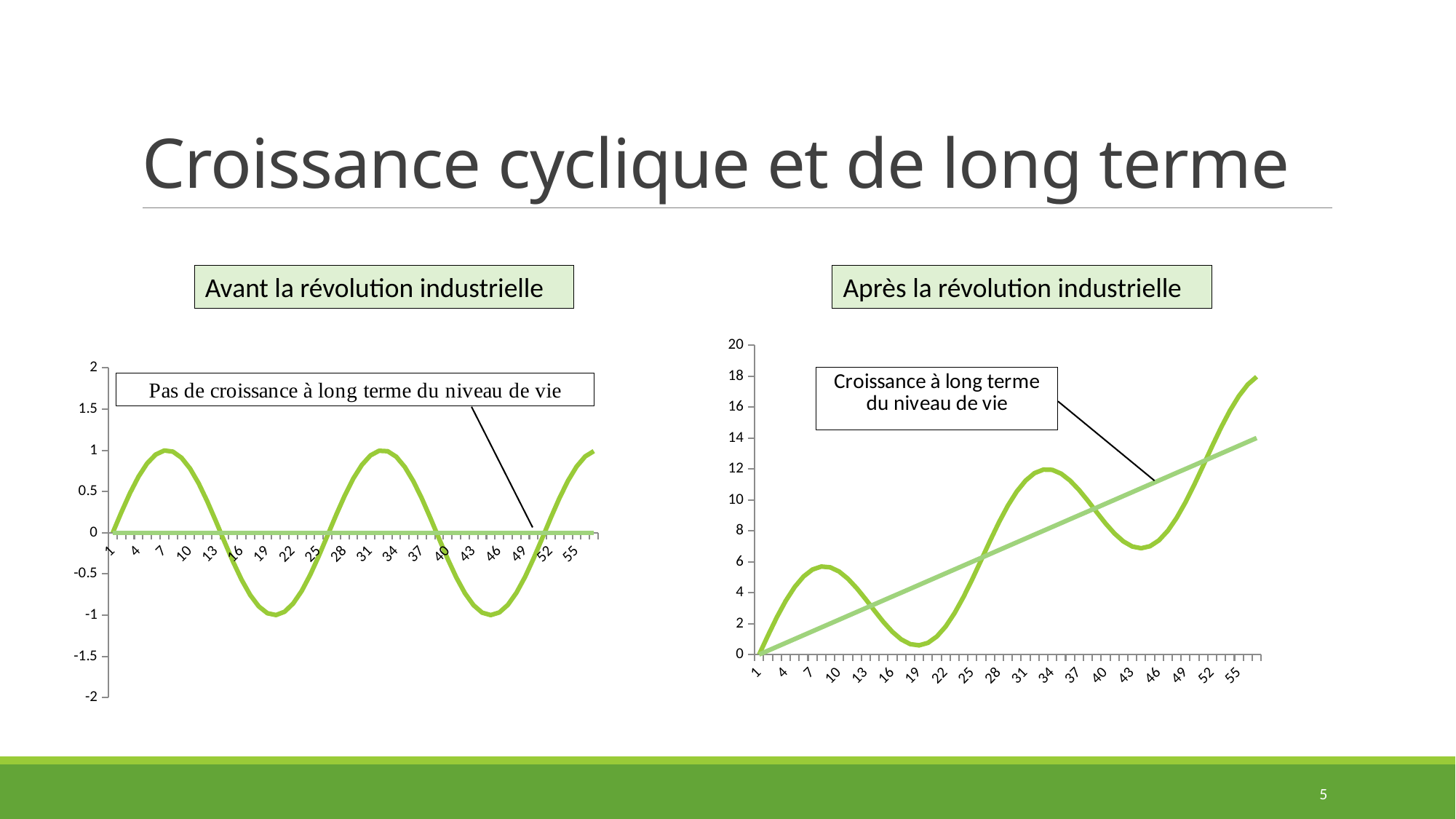
In the "Après la révolution industrielle" chart, is the value of the wavy line at x = 19 greater or less than 2? less In the "Après la révolution industrielle" chart, does the straight line rise or fall along the x axis? Rise In the "Avant la révolution industrielle" chart, what is the lowest value reached by the wavy line? -1 In the "Après la révolution industrielle" chart, is the value of the wavy line at x = 34 greater or less than 10? greater In the "Après la révolution industrielle" chart, what is the highest value shown on the y axis? 20 What kind of chart is shown under "Après la révolution industrielle"? Line chart In the "Après la révolution industrielle" chart, is the value of the wavy line at x = 55 greater or less than 16? greater What kind of chart is shown under "Avant la révolution industrielle"? Line chart What does the annotation on the "Avant la révolution industrielle" chart say? Pas de croissance à long terme du niveau de vie In the "Avant la révolution industrielle" chart, does the straight line rise, fall or stay flat along the x axis? Stay flat In the "Avant la révolution industrielle" chart, what is the highest value reached by the wavy line? 1